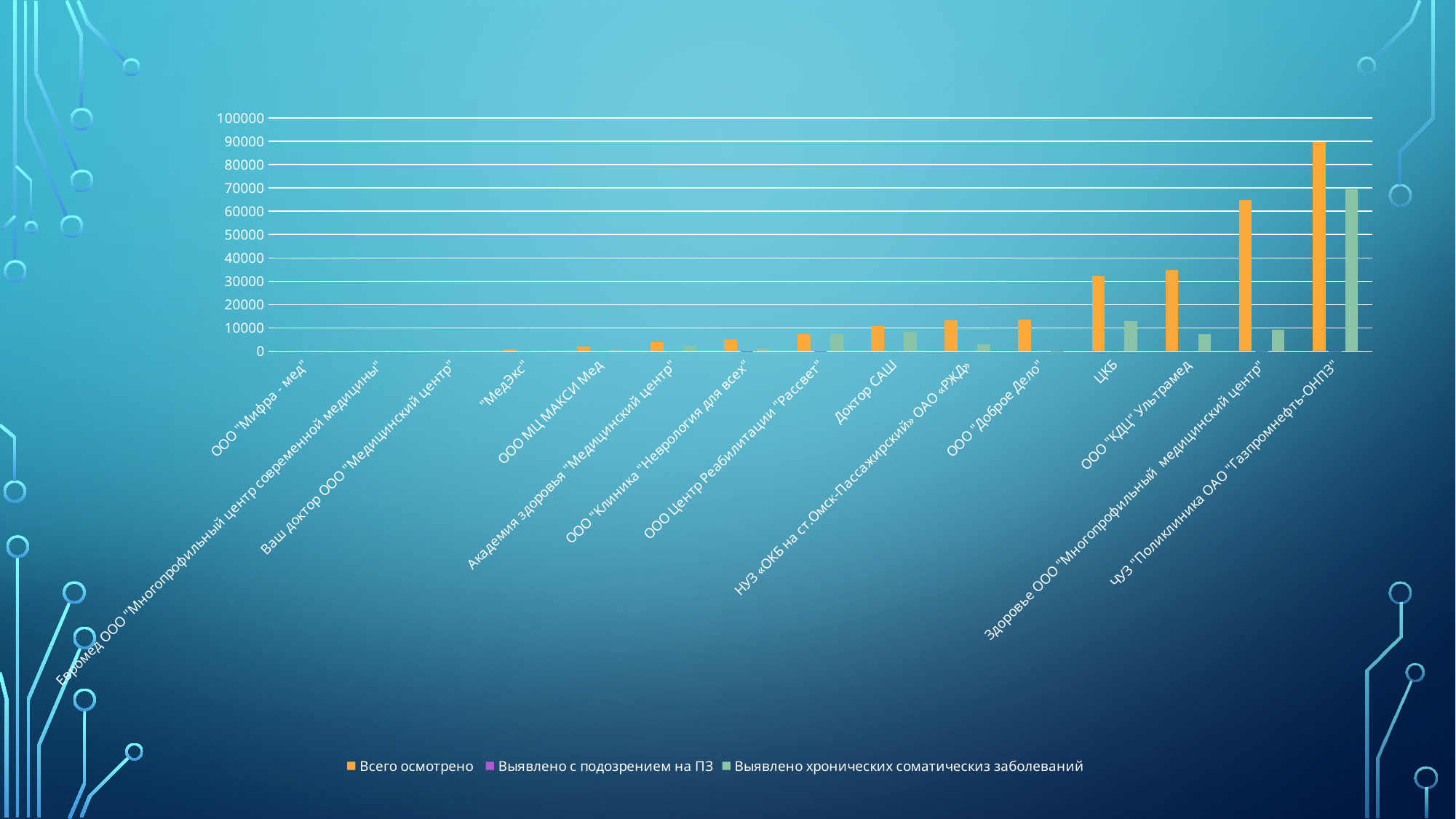
Do the "Всего осмотрено" values generally rise or fall from left to right along the x axis? rise Which organisation has the highest value for "Всего осмотрено"? ЧУЗ "Поликлиника ОАО "Газпромнефть-ОНПЗ" Is the "Всего осмотрено" value for ЧУЗ "Поликлиника ОАО "Газпромнефть-ОНПЗ" greater or less than 80000? greater Which has the larger "Всего осмотрено" value: ЦКБ or Здоровье ООО "Многопрофильный медицинский центр"? Здоровье ООО "Многопрофильный медицинский центр" Is the "Всего осмотрено" value for ЦКБ greater or less than 20000? greater How many categories (organisations) are shown on the x axis? 15 Is the "Всего осмотрено" value for Здоровье ООО "Многопрофильный медицинский центр" greater or less than 60000? greater What kind of chart is shown on the slide? bar chart Which has the larger "Выявлено хронических соматическиз заболеваний" value: ЦКБ or ООО "КДЦ" Ультрамед? ЦКБ How many series does the legend list? 3